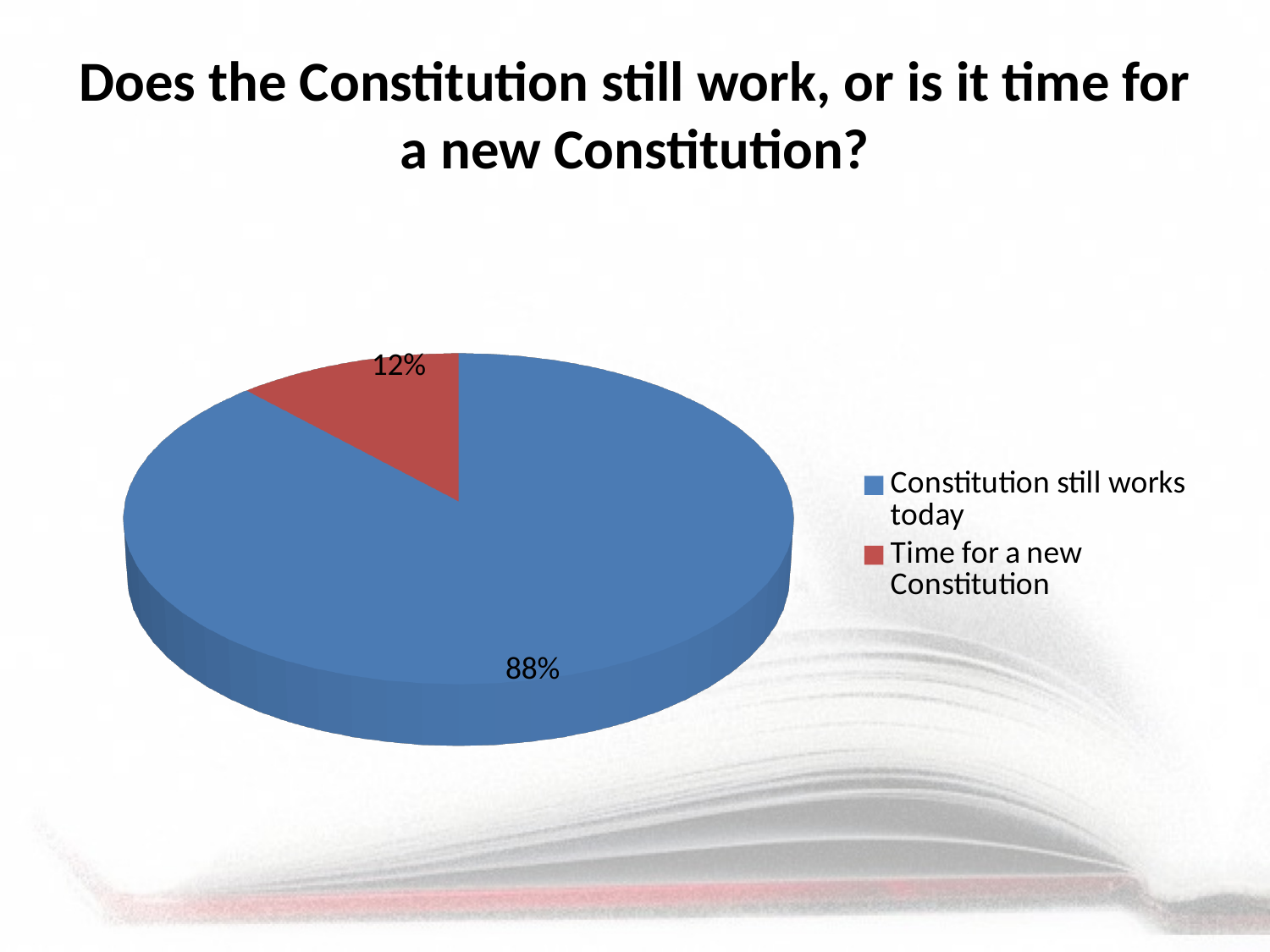
What share of the pie does the "Time for a new Constitution" slice represent? 12% How many entries does the legend list? 2 Which slice of the pie is the smallest? Time for a new Constitution What kind of chart is shown on the slide? Pie chart What is the title shown above the chart? Does the Constitution still work, or is it time for a new Constitution? Which is larger: the share for "Constitution still works today" or the share for "Time for a new Constitution"? Constitution still works today What percentage of the pie is labelled "Constitution still works today"? 88% What is the difference in percentage points between the "Constitution still works today" slice and the "Time for a new Constitution" slice? 76 What percentage of the pie is labelled "Time for a new Constitution"? 12% Which slice of the pie is the largest? Constitution still works today What colour is the "Constitution still works today" slice? Blue How many slices does the pie chart have? 2